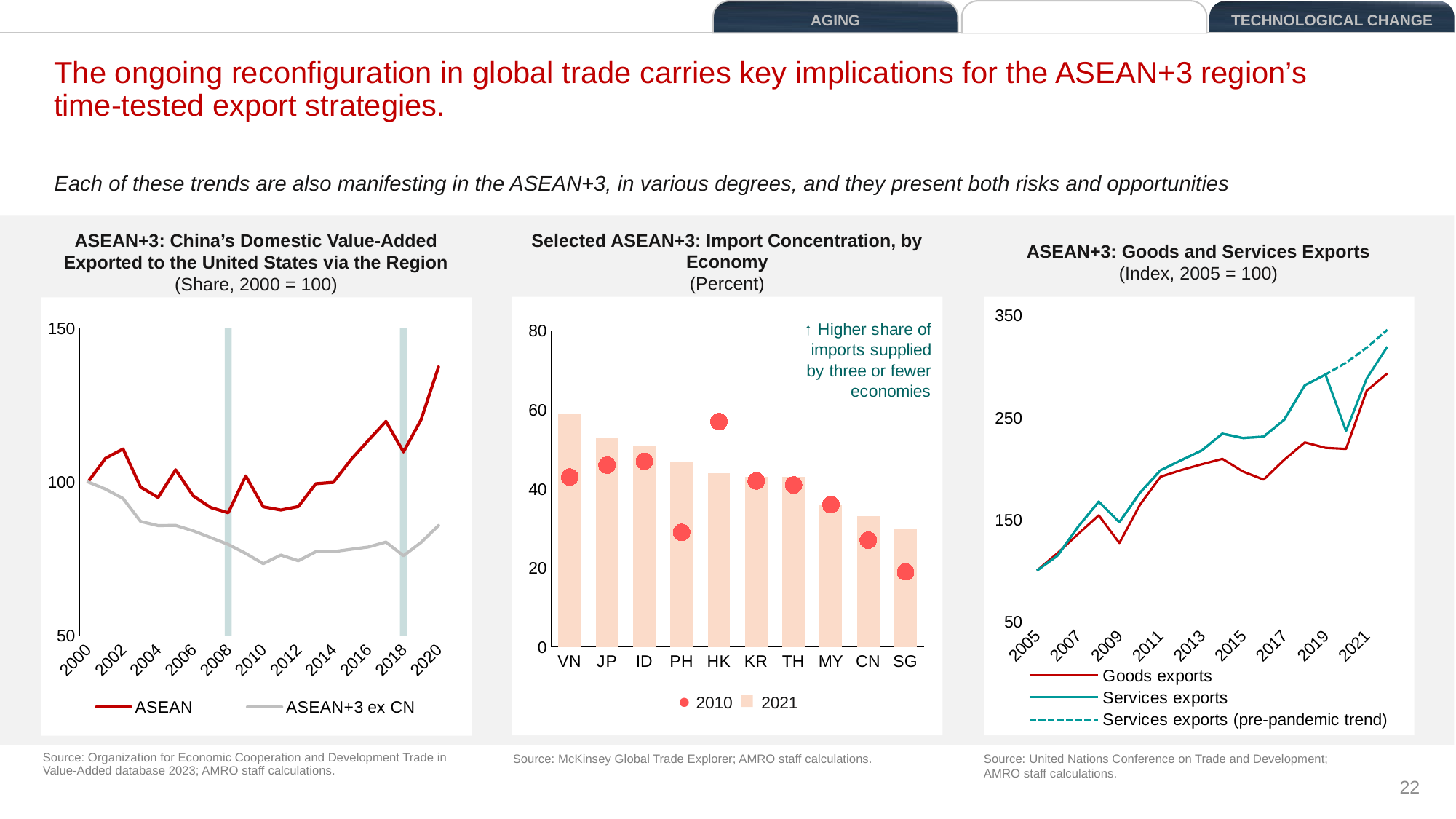
In the 'Selected ASEAN+3: Import Concentration, by Economy' chart, how many economies are shown on the x axis? 10 What kind of chart is 'Selected ASEAN+3: Import Concentration, by Economy'? bar chart In the 'Selected ASEAN+3: Import Concentration, by Economy' chart, is the 2010 value for HK greater or less than 40? greater What kind of chart is 'ASEAN+3: China's Domestic Value-Added Exported to the United States via the Region'? line chart In the 'ASEAN+3: Goods and Services Exports' chart, which series is drawn as a dashed line? Services exports (pre-pandemic trend) In the 'Selected ASEAN+3: Import Concentration, by Economy' chart, which is larger for HK: the 2010 value or the 2021 value? 2010 In the 'Selected ASEAN+3: Import Concentration, by Economy' chart, which economy has the highest 2021 bar? VN In the 'ASEAN+3: China's Domestic Value-Added Exported to the United States via the Region' chart, does the ASEAN+3 ex CN line rise or fall from 2000 to 2010? fall In the 'ASEAN+3: Goods and Services Exports' chart, is the value for Goods exports in 2021 greater or less than 250? greater In the 'Selected ASEAN+3: Import Concentration, by Economy' chart, which economy has the lowest 2010 value? SG In the 'ASEAN+3: China's Domestic Value-Added Exported to the United States via the Region' chart, is the value for ASEAN in 2020 greater or less than 100? greater How many series does the legend list in the 'ASEAN+3: Goods and Services Exports' chart? 3